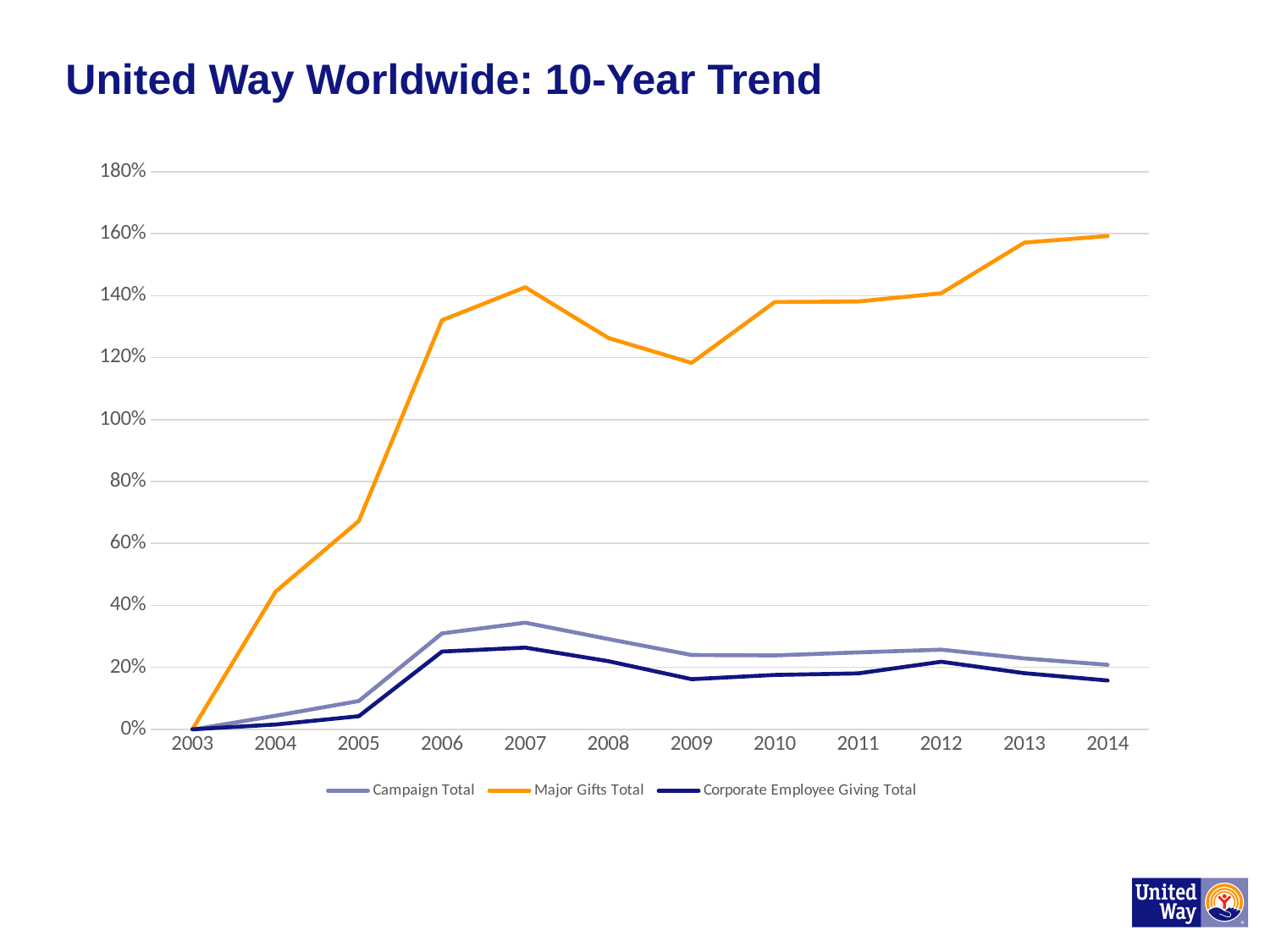
What kind of chart is shown on the slide? line chart How many series does the legend list? 3 Which series has the higher value in 2007, Campaign Total or Corporate Employee Giving Total? Campaign Total Is the value for Campaign Total in 2007 greater or less than 40%? less Which series is drawn in orange? Major Gifts Total Is the value for Major Gifts Total in 2009 greater or less than 100%? greater Is the value for Major Gifts Total in 2014 greater or less than 140%? greater In which year does Major Gifts Total reach its highest value? 2014 What is the value of Major Gifts Total in 2003? 0% How many years are plotted along the x axis? 12 Does Major Gifts Total rise or fall from 2009 to 2014? rise